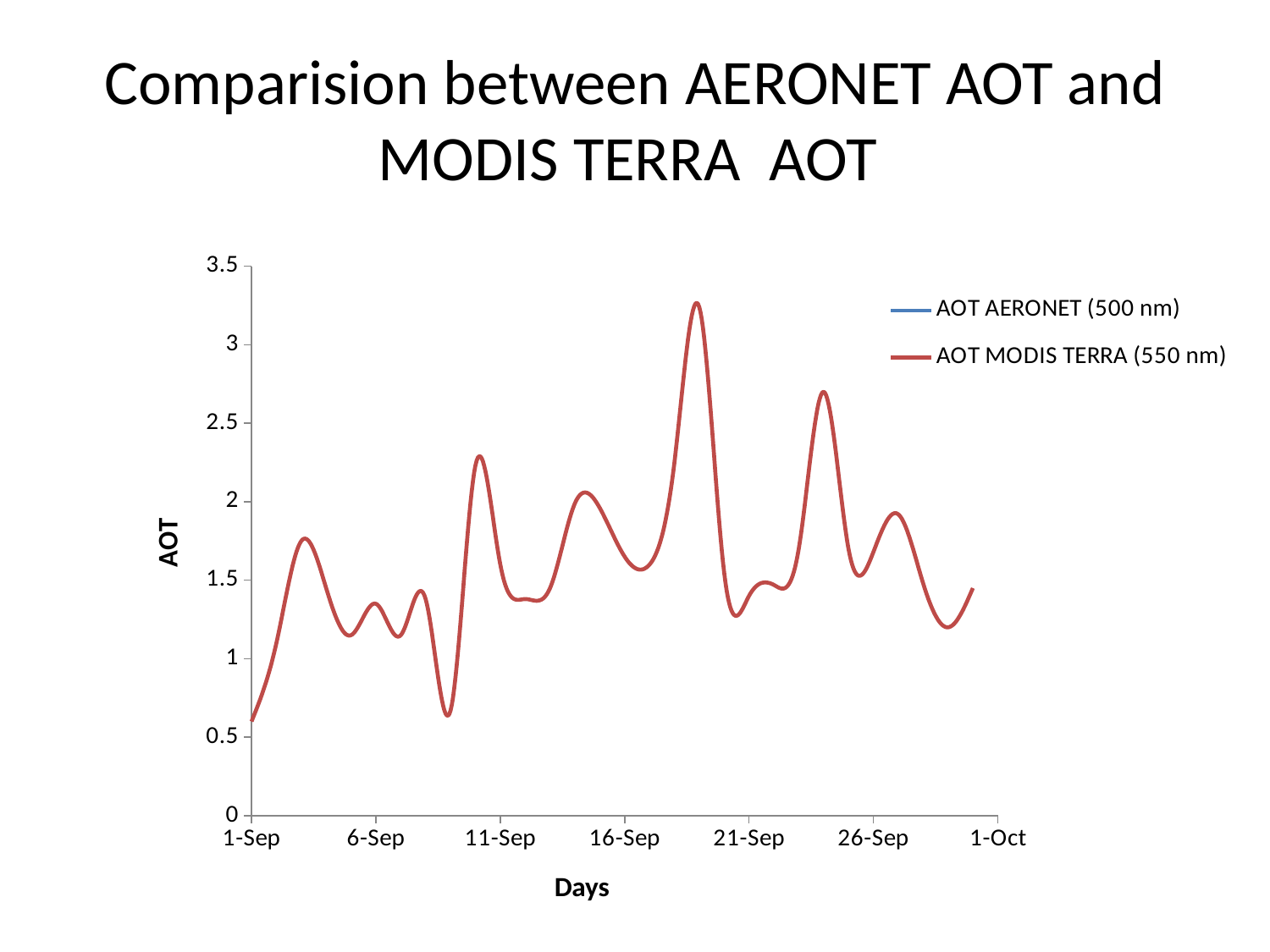
Does the AOT line rise or fall from 1-Sep to its first peak a few days later? rise What is the label of the vertical axis? AOT What is the title of the chart on the slide? Comparision between AERONET AOT and MODIS TERRA AOT Is the AOT value on 6-Sep greater or less than 1.5? less How many series does the legend list? 2 Is the AOT value on 21-Sep greater or less than 1.5? less Is the highest peak of the AOT MODIS TERRA (550 nm) line greater or less than 3? greater How many date labels are shown on the x axis? 7 What is the maximum value shown on the vertical axis? 3.5 What kind of chart is shown on the slide? line chart